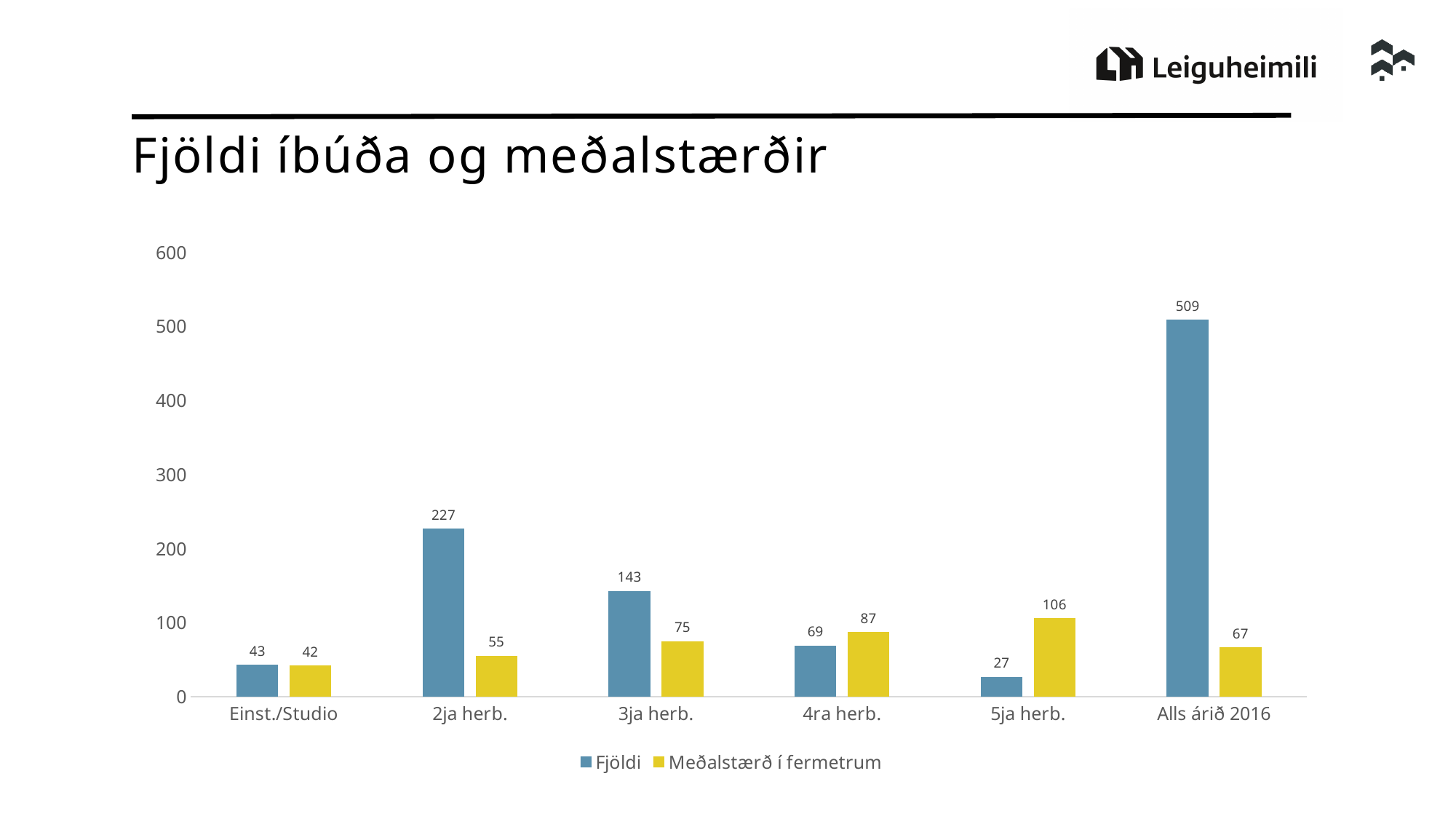
What is the difference between the Fjöldi values for 2ja herb. and 3ja herb.? 84 Is the Fjöldi value for Alls árið 2016 greater or less than 500? greater Which is larger for 4ra herb.: Fjöldi or Meðalstærð í fermetrum? Meðalstærð í fermetrum How many series does the legend list? 2 What kind of chart is shown on the slide? bar chart What is the title of the slide? Fjöldi íbúða og meðalstærðir Which category has the highest Meðalstærð í fermetrum value? 5ja herb. What is the Meðalstærð í fermetrum value for 5ja herb.? 106 What is the Fjöldi value for 2ja herb.? 227 Which category has the lowest Fjöldi value? 5ja herb. What is the Fjöldi value for Alls árið 2016? 509 How many categories are shown on the x axis? 6